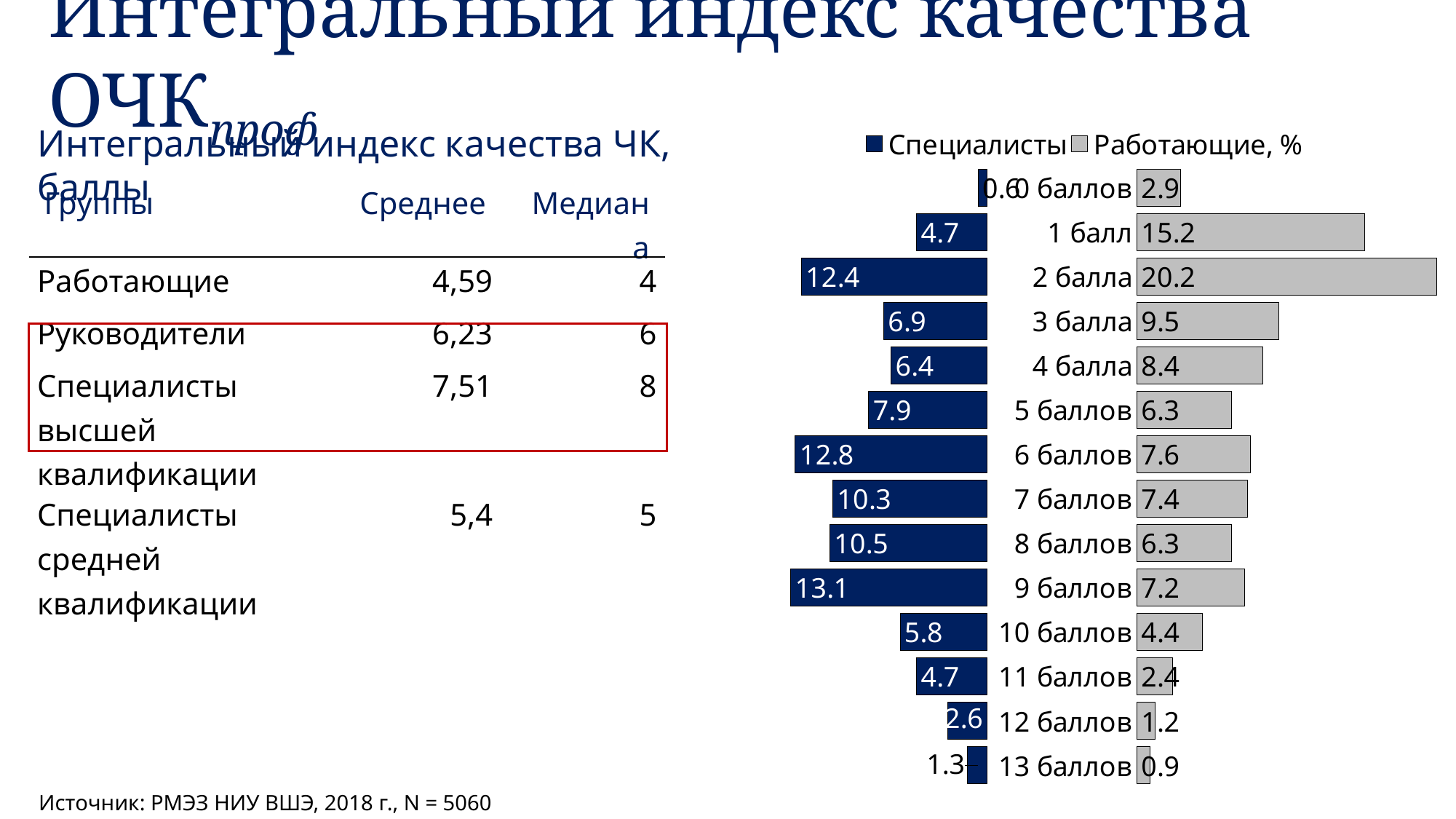
In the chart, what is the value for Специалисты at 9 баллов? 13.1 What kind of chart is shown on the right side of the slide? bar chart In the chart, what is the difference between Работающие, % and Специалисты at 2 балла? 7.8 How many series does the legend of the chart list? 2 In the chart, what is the value for Работающие, % at 13 баллов? 0.9 In the chart, which score category has the lowest value for Специалисты? 0 баллов In the chart, at 1 балл, which series has the larger value: Специалисты or Работающие, %? Работающие, % In the chart, what is the value for Специалисты at 6 баллов? 12.8 In the chart, which score category has the highest value for Работающие, %? 2 балла How many score categories (баллов) are plotted in the chart? 14 What are the two legend entries of the chart? Специалисты; Работающие, % In the chart, what is the value for Работающие, % at 2 балла? 20.2